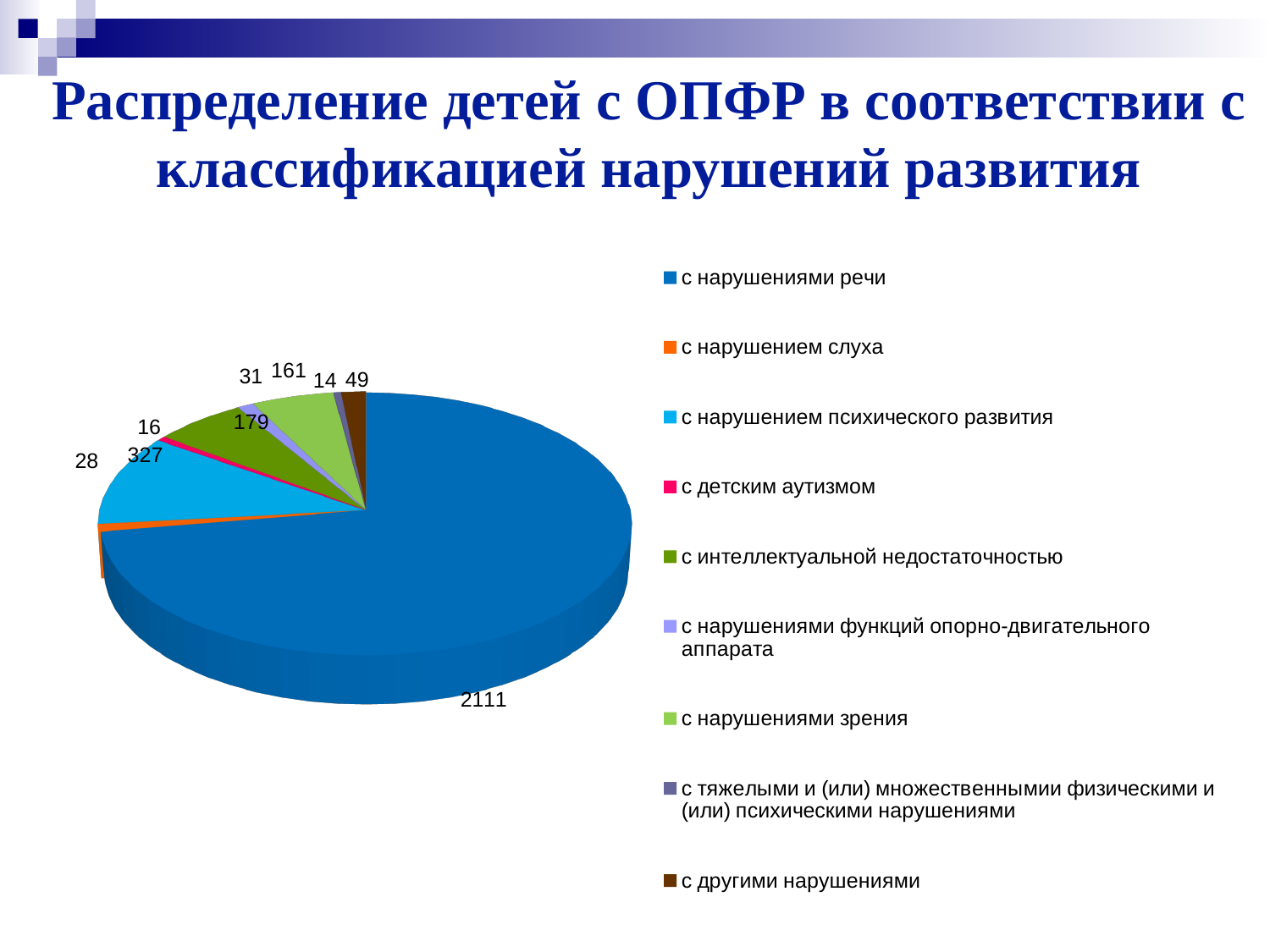
What is the value for the category 'с нарушениями зрения'? 161 What is the value for the category 'с другими нарушениями'? 49 Which category has the smallest value in the pie chart? с тяжелыми и (или) множественнымии физическими и (или) психическими нарушениями What is the value for the category 'с интеллектуальной недостаточностью'? 179 Which is larger: the value for 'с нарушением слуха' or the value for 'с детским аутизмом'? с нарушением слуха What is the difference between the values for 'с нарушением психического развития' and 'с интеллектуальной недостаточностью'? 148 What is the title of the chart on the slide? Распределение детей с ОПФР в соответствии с классификацией нарушений развития Which category has the largest slice of the pie? с нарушениями речи What is the value for the category 'с нарушением психического развития'? 327 What is the value for the category 'с нарушениями речи'? 2111 What kind of chart is shown on the slide? pie chart How many categories does the legend of the pie chart list? 9